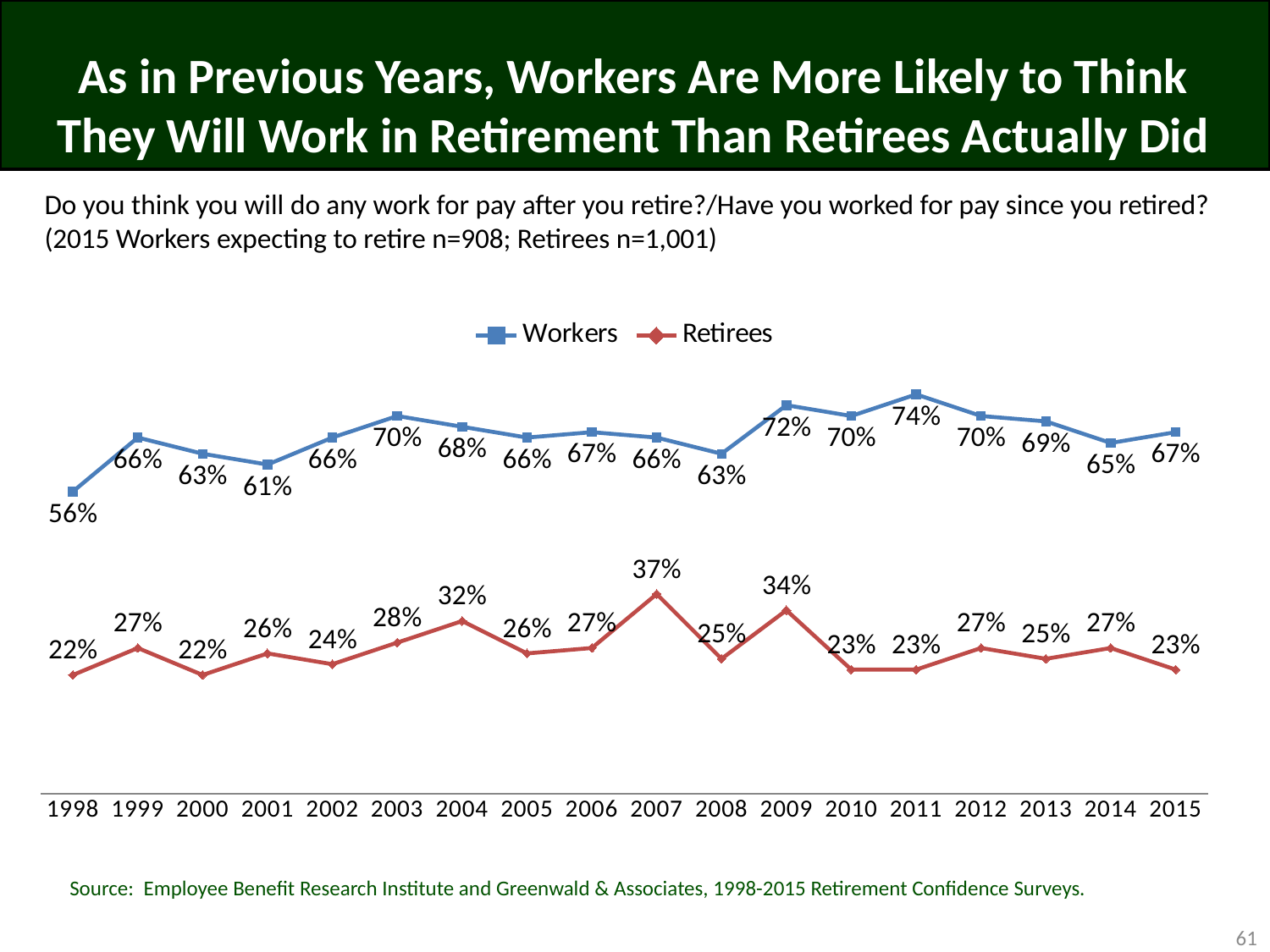
What is the value for Workers in 2015? 67% What is the value for Retirees in 2007? 37% How many years are shown on the x axis? 18 What is the difference between the Workers and Retirees values in 2015? 44 percentage points Which is larger, the Retirees value in 2004 or the Retirees value in 2008? 2004 What kind of chart is shown on the slide? Line chart How many series does the legend list? 2 What is the value for Retirees in 2009? 34% What is the value for Workers in 1998? 56% In which year is the Workers value lowest? 1998 In which year is the Workers value highest? 2011 In which year is the Retirees value highest? 2007